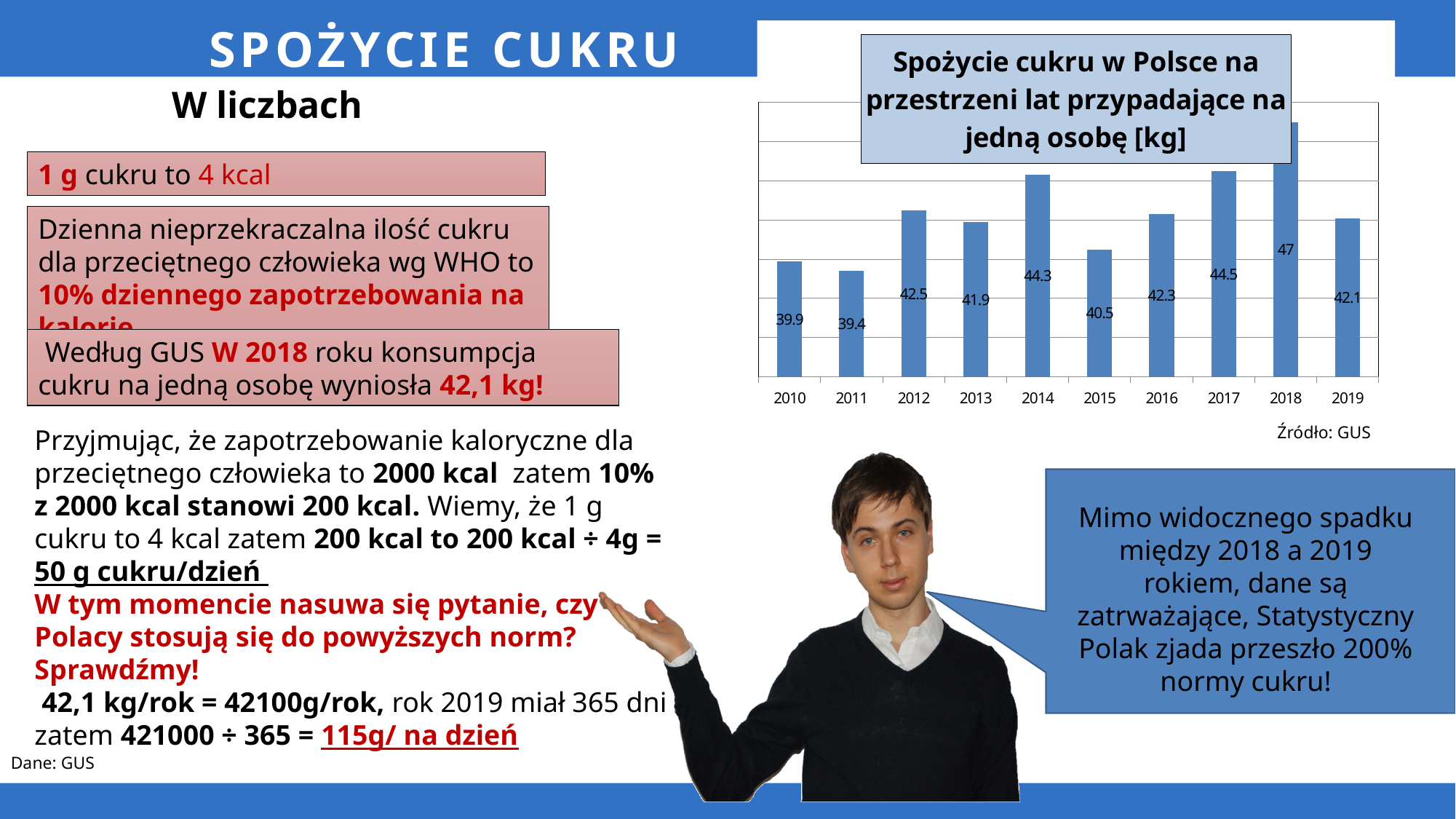
Which year has the highest value? 2018 What is the source of the chart data, as stated below the chart? GUS What is the value for 2011? 39.4 What is the difference between the values for 2018 and 2019? 4.9 How many years are shown on the x axis? 10 What is the value for 2019? 42.1 What is the difference between the values for 2017 and 2015? 4 What is the value for 2018? 47 Which is larger, the value for 2012 or the value for 2013? 2012 What kind of chart is shown on the slide? bar chart Which year has the lowest value? 2011 What is the value for 2014? 44.3